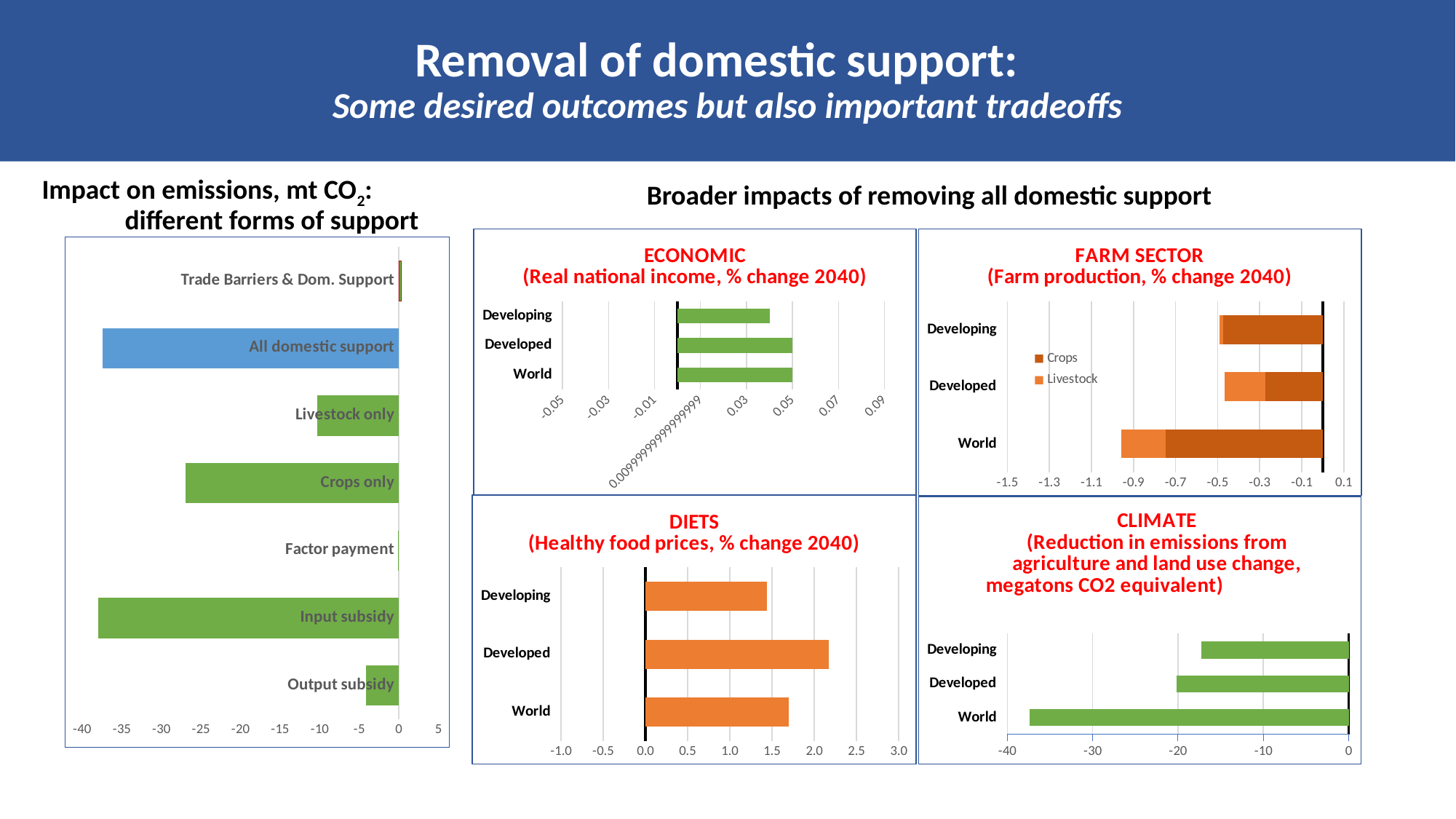
In the DIETS chart, is the value for Developed greater or less than 2.0? greater In the 'Impact on emissions, mt CO2: different forms of support' chart, which bar extends further to the left, Crops only or Livestock only? Crops only In the ECONOMIC chart, which category has the lowest value? Developing In the 'Impact on emissions, mt CO2: different forms of support' chart, is the value for Livestock only greater or less than -15? greater In the CLIMATE chart, is the value for World greater or less than -30? less How many series does the legend of the FARM SECTOR chart list? 2 How many categories are shown in the 'Impact on emissions, mt CO2: different forms of support' chart? 7 In the DIETS chart, which category has the lowest value? Developing What type of chart is the 'Impact on emissions, mt CO2: different forms of support' chart? bar chart In the DIETS chart, which category has the highest value? Developed In the CLIMATE chart, which bar extends further to the left, Developing or Developed? Developed